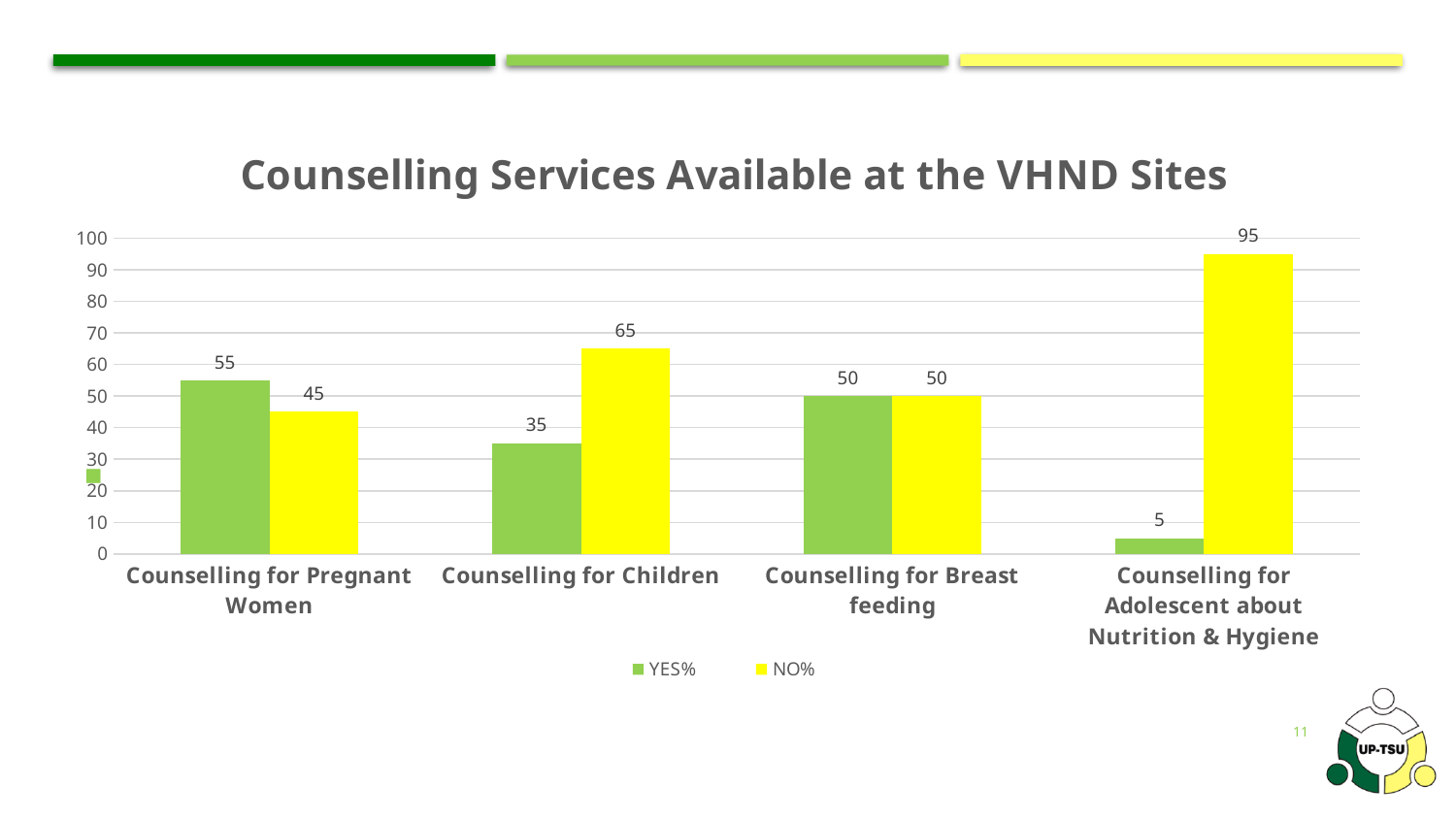
Which category has the highest NO% value? Counselling for Adolescent about Nutrition & Hygiene What is the YES% value for Counselling for Pregnant Women? 55 What is the title of the chart? Counselling Services Available at the VHND Sites How many series does the legend list? 2 What kind of chart is shown on the slide? Bar chart What is the difference between the NO% and YES% values for Counselling for Children? 30 Which category has the lowest YES% value? Counselling for Adolescent about Nutrition & Hygiene Which is larger for Counselling for Pregnant Women, the YES% value or the NO% value? YES% How many categories are shown on the x axis? 4 What colour represents the NO% series in the chart? Yellow What is the NO% value for Counselling for Children? 65 What is the YES% value for Counselling for Adolescent about Nutrition & Hygiene? 5